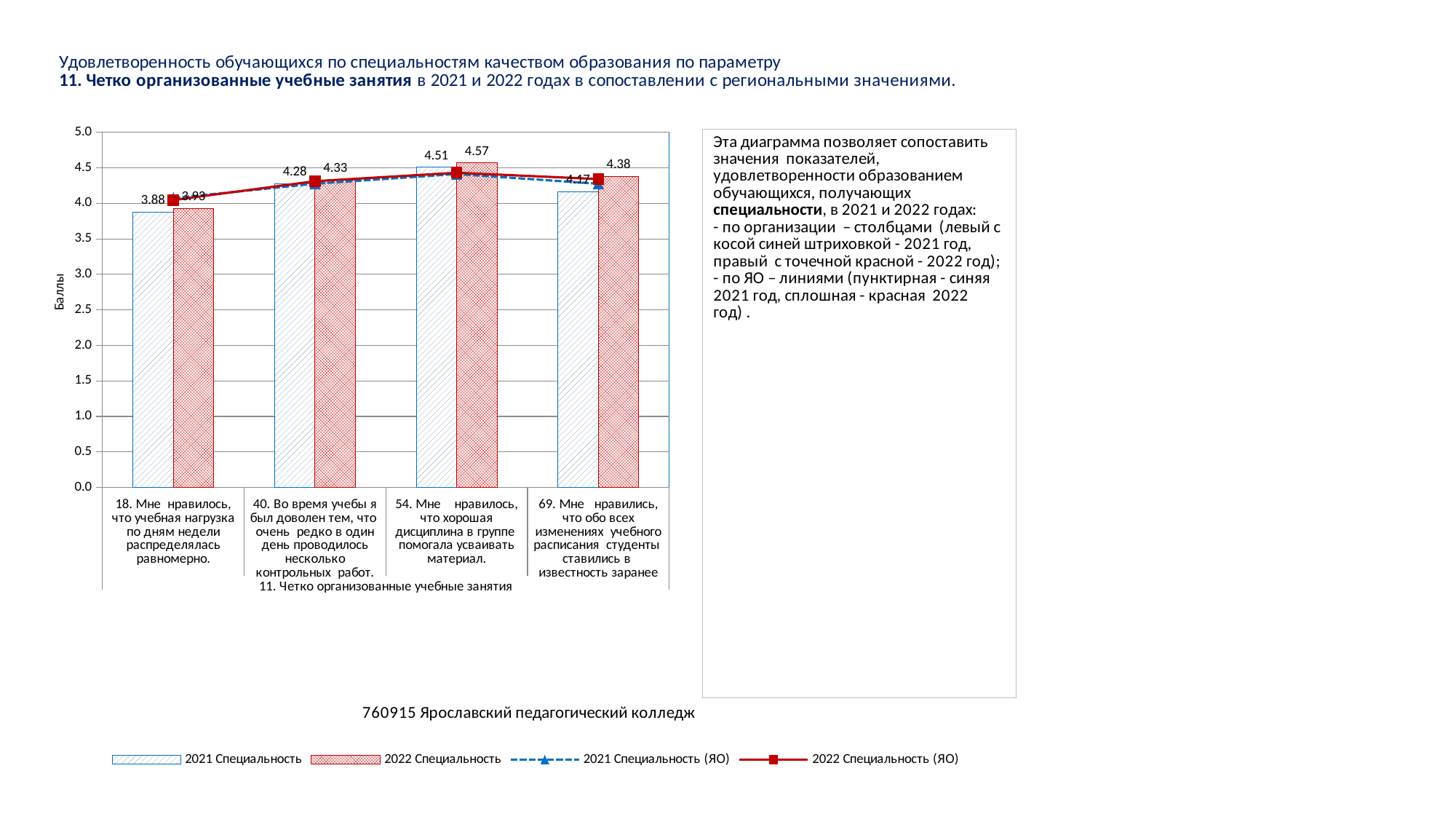
How many series does the chart legend list? 4 What is the title of the vertical axis of the chart? Баллы Which question has the highest 2022 Специальность bar? 54. Мне нравилось, что хорошая дисциплина в группе помогала усваивать материал. For question 69, how much higher is the 2022 Специальность value than the 2021 Специальность value? 0.21 Is the 2021 Специальность value for question 40 greater or less than 4.0? greater How many questions (categories) are shown on the x axis of the chart? 4 What is the value of the 2021 Специальность bar for question 69 (Мне нравились, что обо всех изменениях учебного расписания студенты ставились в известность заранее)? 4.17 What is the value of the 2021 Специальность bar for question 18 (Мне нравилось, что учебная нагрузка по дням недели распределялась равномерно)? 3.88 Which question has the lowest 2021 Специальность bar? 18. Мне нравилось, что учебная нагрузка по дням недели распределялась равномерно. Which is larger: the 2022 Специальность value for question 54 or for question 40? Question 54 (4.57) What is the value of the 2022 Специальность bar for question 40 (Во время учебы я был доволен тем, что очень редко в один день проводилось несколько контрольных работ)? 4.33 What is the value of the 2022 Специальность bar for question 54 (Мне нравилось, что хорошая дисциплина в группе помогала усваивать материал)? 4.57